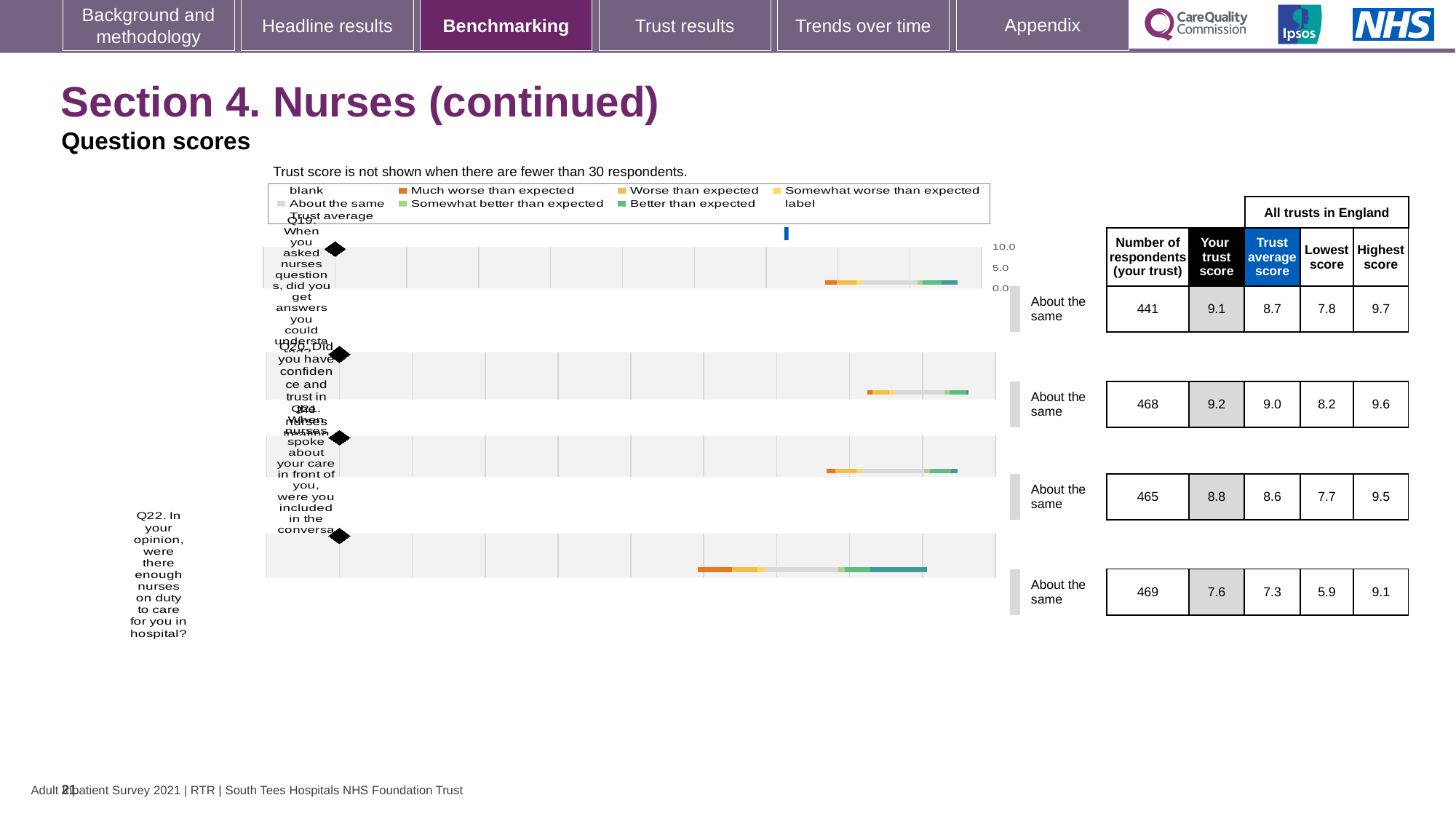
How many respondents from your trust answered Q20? 468 What is the 'Lowest score' across all trusts in England for Q20? 8.2 For Q21, which is larger: 'Your trust score' or the 'Trust average score'? Your trust score Which question has the lowest 'Your trust score'? Q22 What is the 'Your trust score' value for Q22 (were there enough nurses on duty)? 7.6 What kind of chart is used to show the question scores on this slide? bar chart How many questions (categories) are plotted in the chart? 4 What is the maximum value shown on the chart's score axis? 10.0 What is the difference between 'Your trust score' and the 'Trust average score' for Q19? 0.4 What benchmark category is shown next to each of the four questions? About the same Which question has the highest 'Your trust score'? Q20 What is the 'Highest score' across all trusts in England for Q22? 9.1